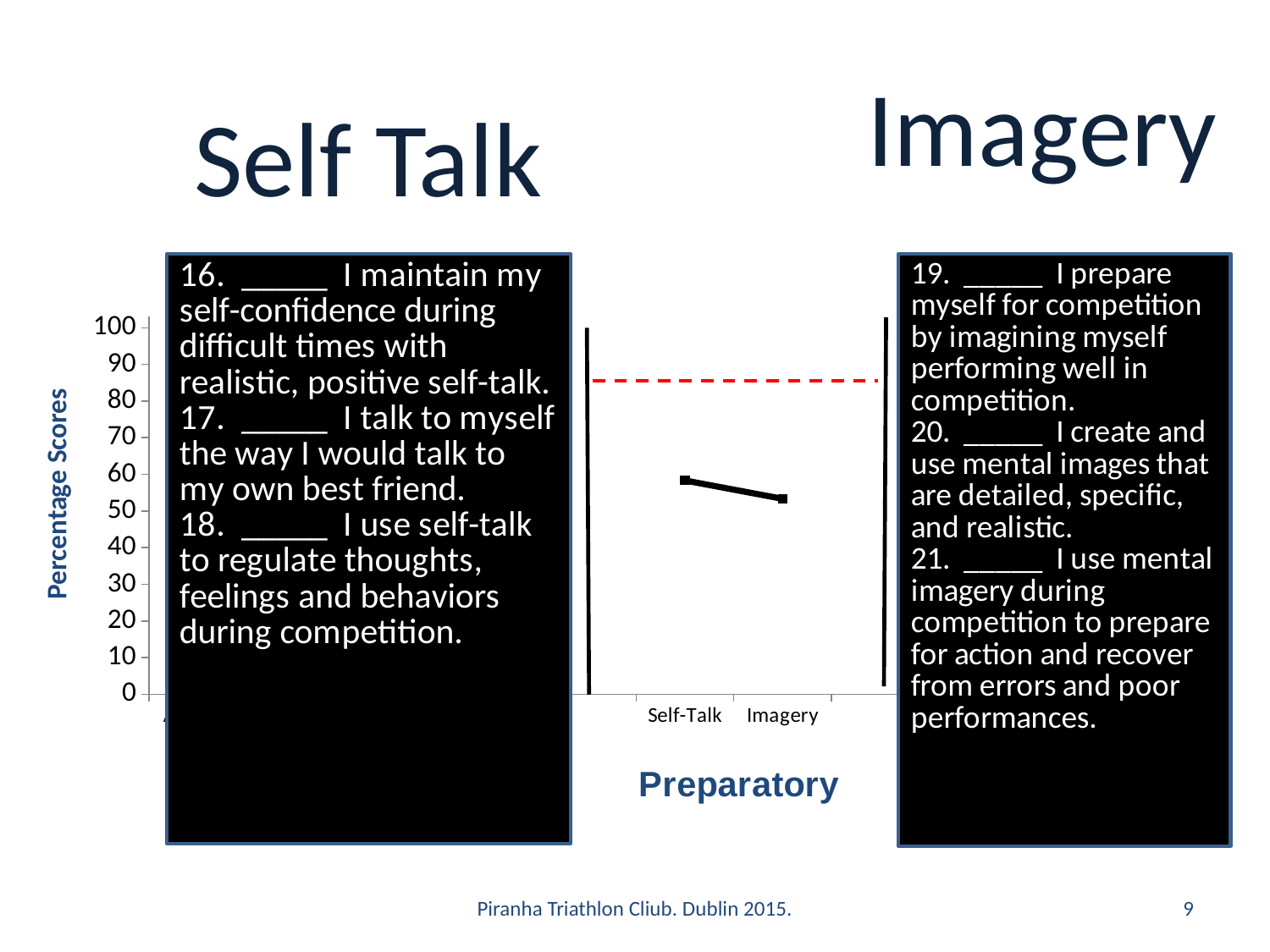
What is the title of the vertical axis of the chart? Percentage Scores Is the value for Imagery greater or less than 40? greater What kind of chart is shown on the slide? line chart What is the highest value shown on the vertical axis of the chart? 100 Is the value for Self-Talk greater or less than 70? less Is the red dashed reference line above or below 80 on the vertical axis? above Which has the higher value, Self-Talk or Imagery? Self-Talk Does the plotted line rise or fall from Self-Talk to Imagery? fall